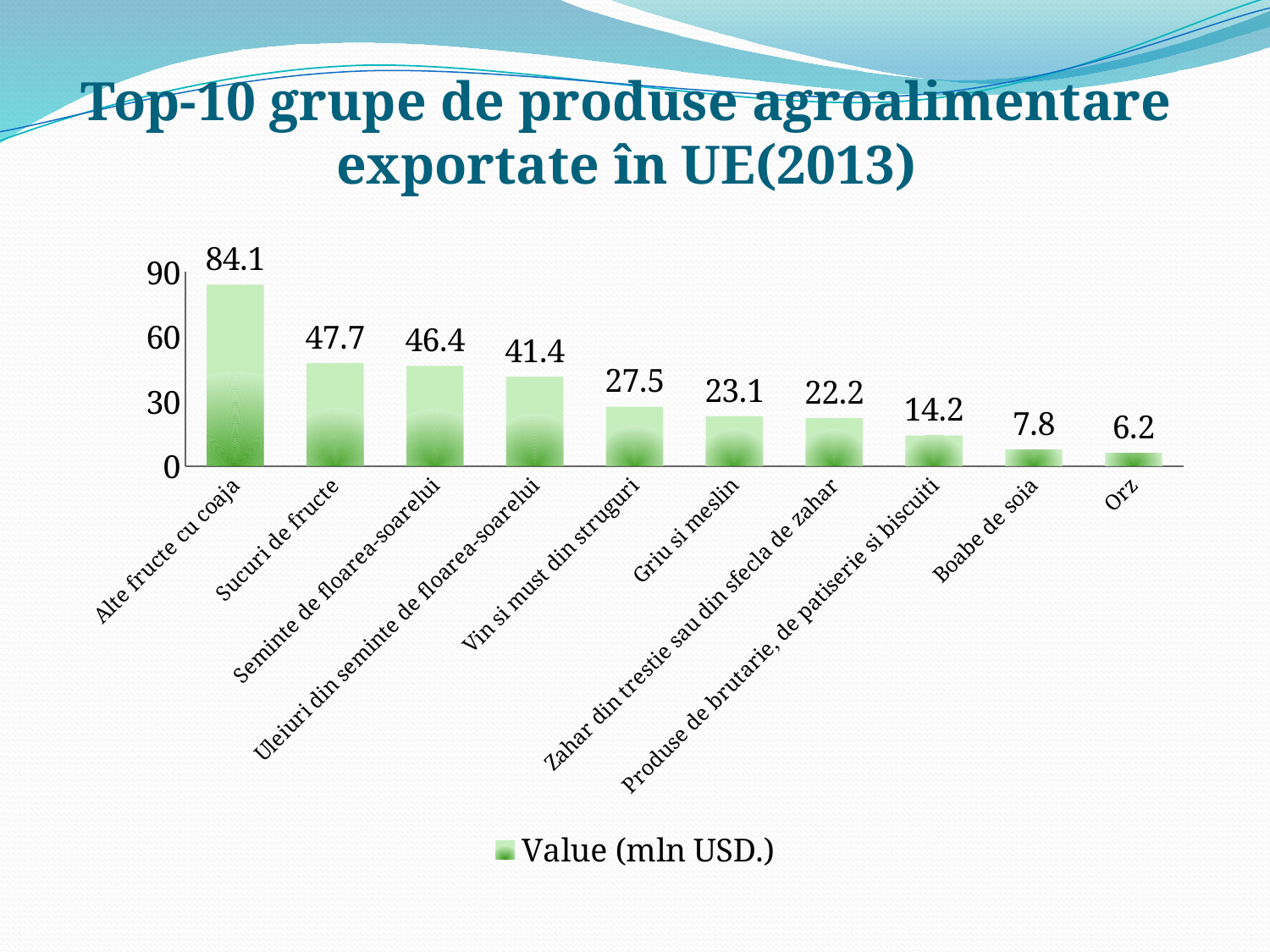
What kind of chart is shown on the slide? bar chart What is the difference between the values for Sucuri de fructe and Seminte de floarea-soarelui? 1.3 What is the value for Vin si must din struguri? 27.5 What is the legend entry of the chart? Value (mln USD.) What is the value for Alte fructe cu coaja? 84.1 Which category has the highest value? Alte fructe cu coaja Which category has the lowest value? Orz What is the difference between the values for Alte fructe cu coaja and Orz? 77.9 Which is larger, the value for Griu si meslin or the value for Zahar din trestie sau din sfecla de zahar? Griu si meslin How many categories are shown in the chart? 10 What is the value for Boabe de soia? 7.8 Is the value for Uleiuri din seminte de floarea-soarelui greater or less than 30? greater